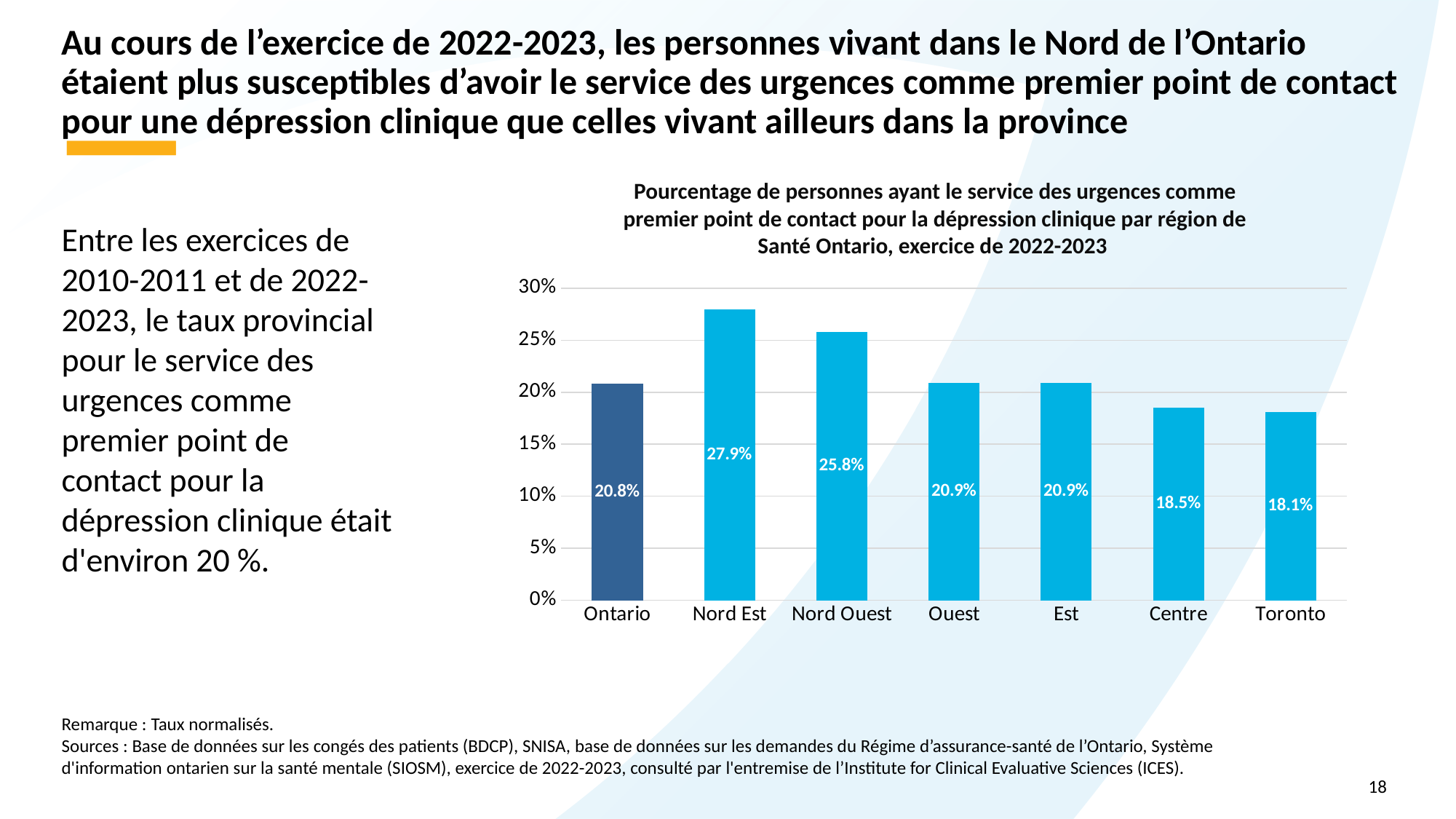
Which bar is shown in a darker blue colour than the others? Ontario What is the value for Nord Est? 27.9% Which category has the lowest value? Toronto What is the value for Centre? 18.5% What kind of chart is shown on the slide? Bar chart How many categories are shown on the x axis? 7 Which is larger, the value for Nord Ouest or the value for Ouest? Nord Ouest What is the value for Toronto? 18.1% Which region has the highest value? Nord Est What is the value for Ontario? 20.8% Is the value for Nord Est greater or less than 25%? greater What is the difference between the values for Nord Est and Nord Ouest? 2.1%